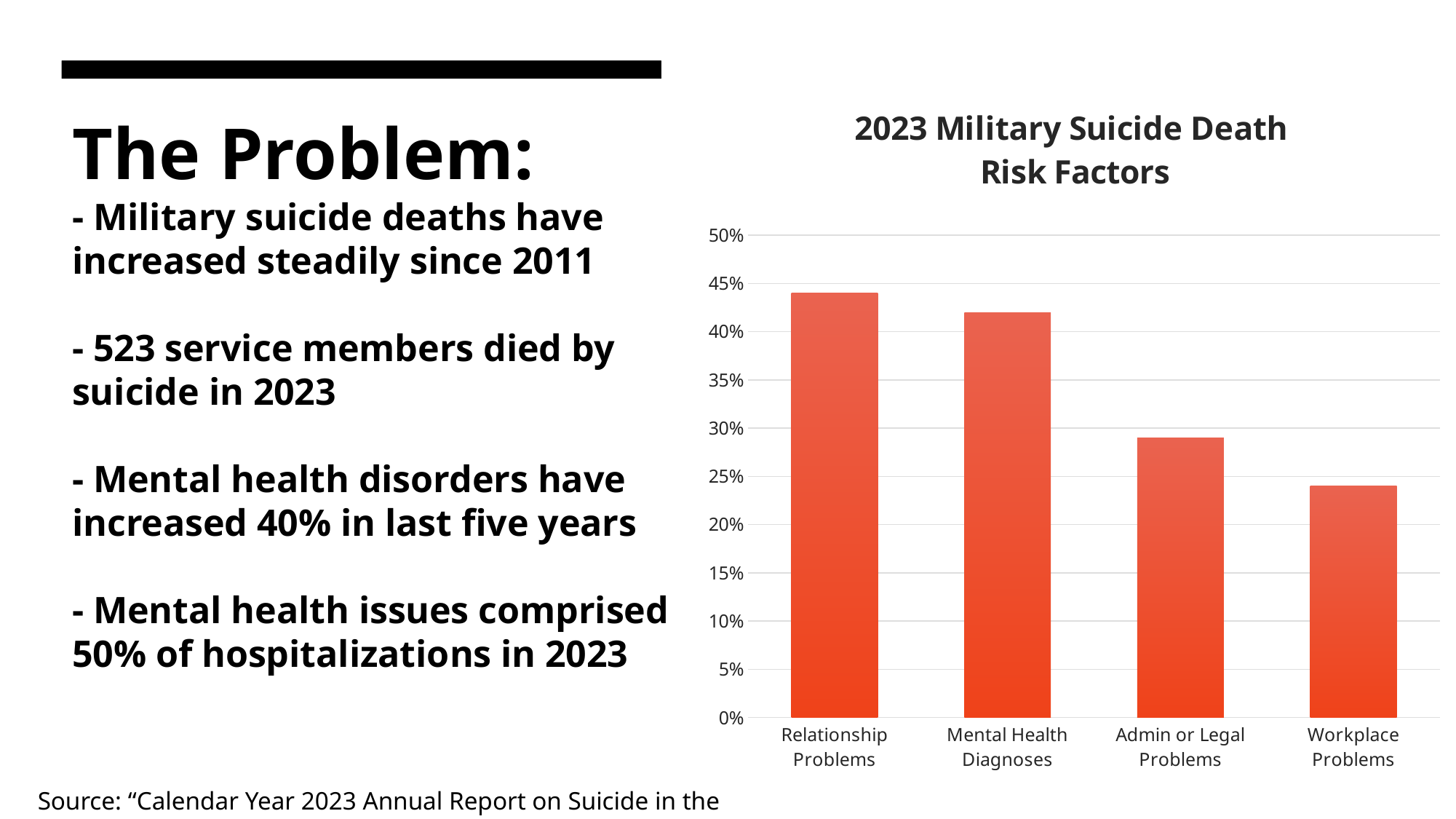
Which risk factor has the highest value in the chart? Relationship Problems Which risk factor has the lowest value in the chart? Workplace Problems Do the bar values rise or fall from left to right across the categories? Fall Is the value for Admin or Legal Problems greater or less than 25%? greater Is the value for Relationship Problems greater or less than 40%? greater Is the value for Mental Health Diagnoses greater or less than 40%? greater How many risk factor categories are plotted in the chart? 4 What kind of chart is shown on the slide? Bar chart What is the title of the chart? 2023 Military Suicide Death Risk Factors Which is larger, the value for Mental Health Diagnoses or the value for Admin or Legal Problems? Mental Health Diagnoses